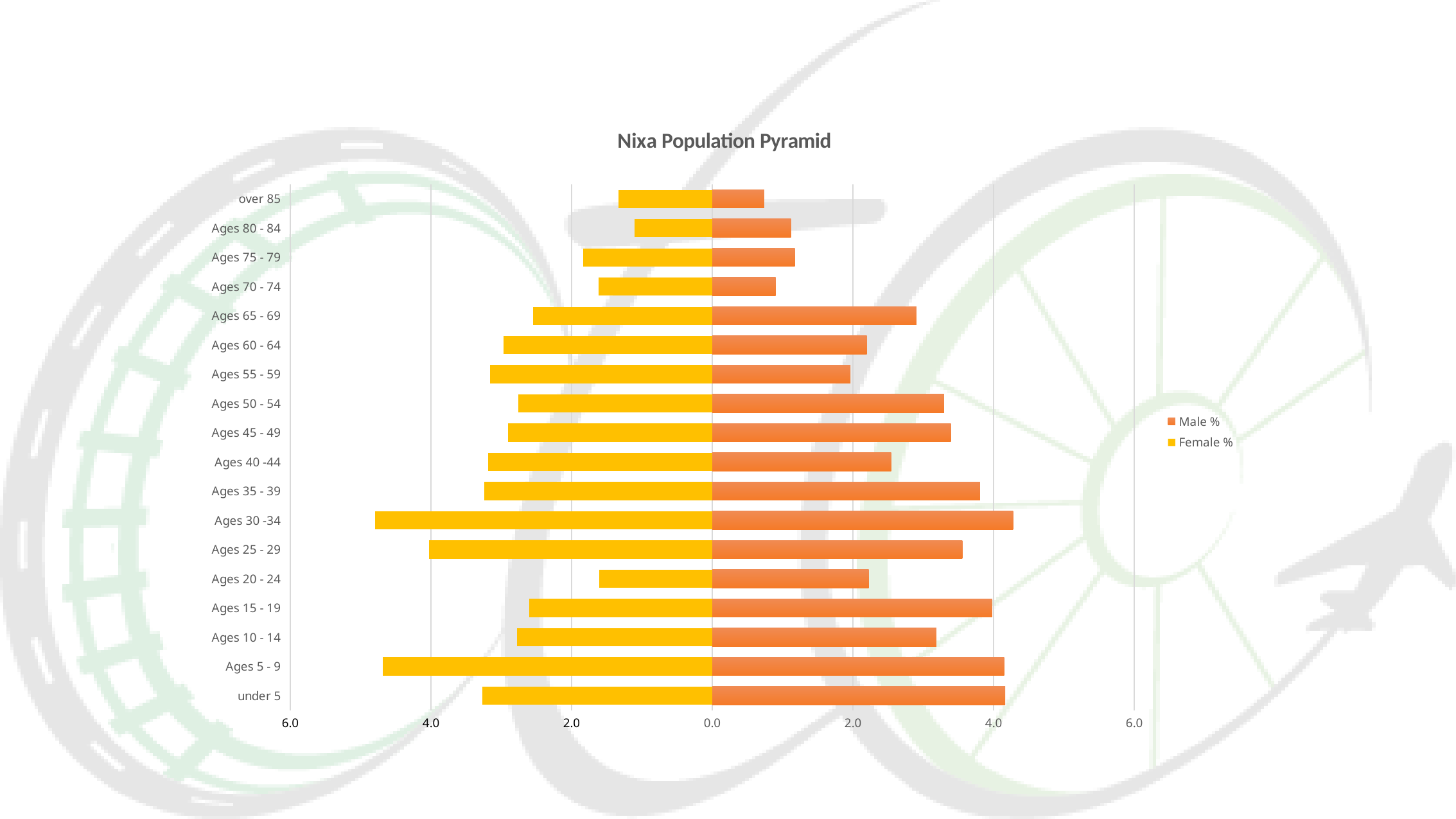
Is the Female % value for Ages 20 - 24 greater or less than 2.0? less How many series does the legend list? 2 What kind of chart is shown on the slide? bar chart Is the Male % value for over 85 greater or less than 2.0? less Which age group has the lowest Female % value? Ages 80 - 84 Which two series are listed in the legend? Male % and Female % Is the Male % value for Ages 35 - 39 greater or less than 4.0? less Which is larger, the Male % value for Ages 65 - 69 or for Ages 60 - 64? Ages 65 - 69 What is the title of the chart? Nixa Population Pyramid How many age categories are plotted on the chart? 18 Which is larger, the Female % value for Ages 25 - 29 or for Ages 20 - 24? Ages 25 - 29